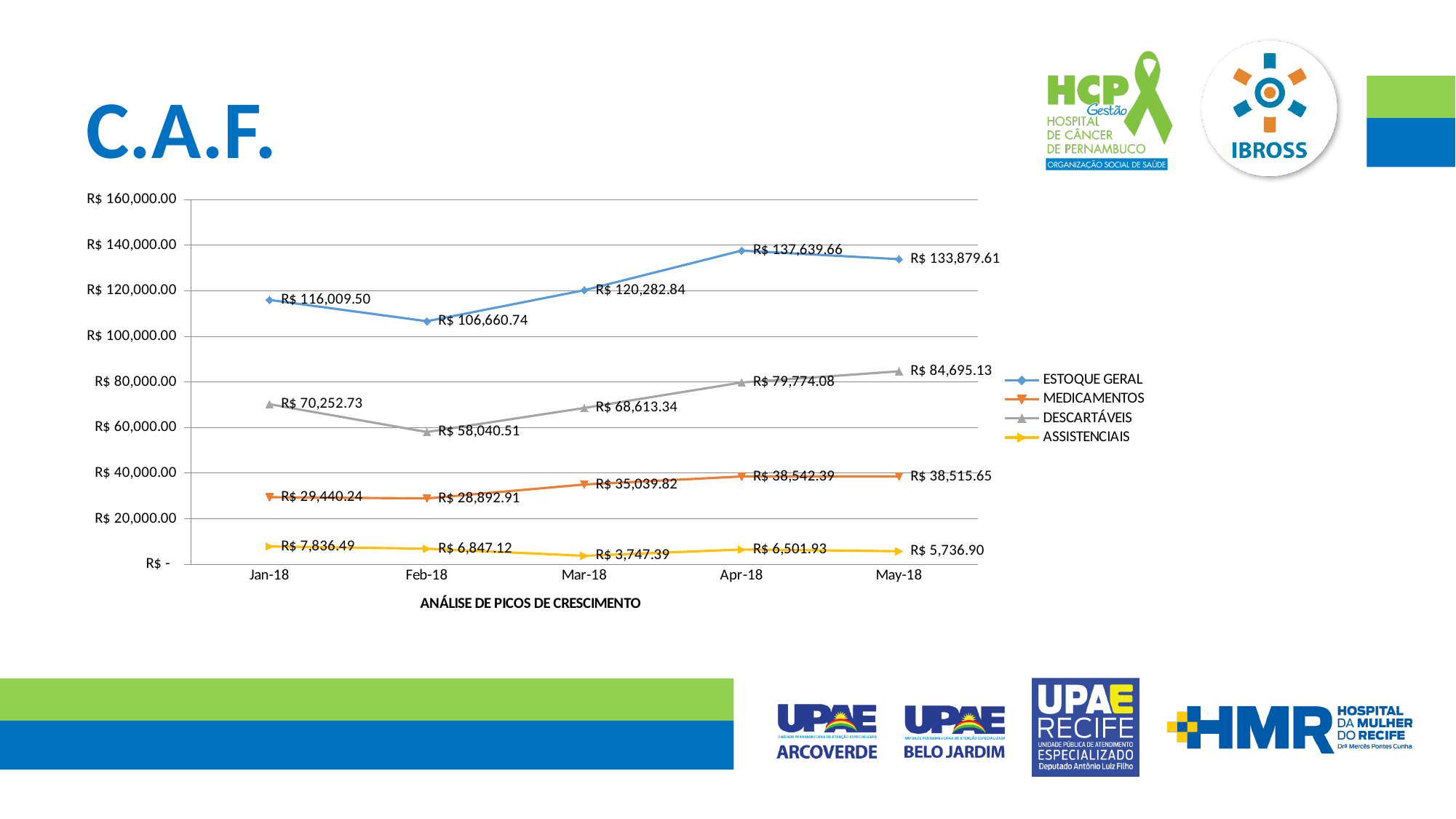
What is the value for ESTOQUE GERAL in Apr-18? R$ 137,639.66 In which month is the ASSISTENCIAIS value lowest? Mar-18 Is the value for ESTOQUE GERAL in Feb-18 greater or less than R$ 100,000.00? greater What is the difference between the ESTOQUE GERAL values for Apr-18 and Mar-18? R$ 17,356.82 What is the value for ASSISTENCIAIS in Jan-18? R$ 7,836.49 How many months are plotted on the x axis? 5 What kind of chart is shown on the slide? line chart How many series does the legend list? 4 In which month does ESTOQUE GERAL reach its highest value? Apr-18 Which is larger: DESCARTÁVEIS in May-18 or DESCARTÁVEIS in Jan-18? May-18 What is the value for MEDICAMENTOS in Mar-18? R$ 35,039.82 In which month is the DESCARTÁVEIS value lowest? Feb-18